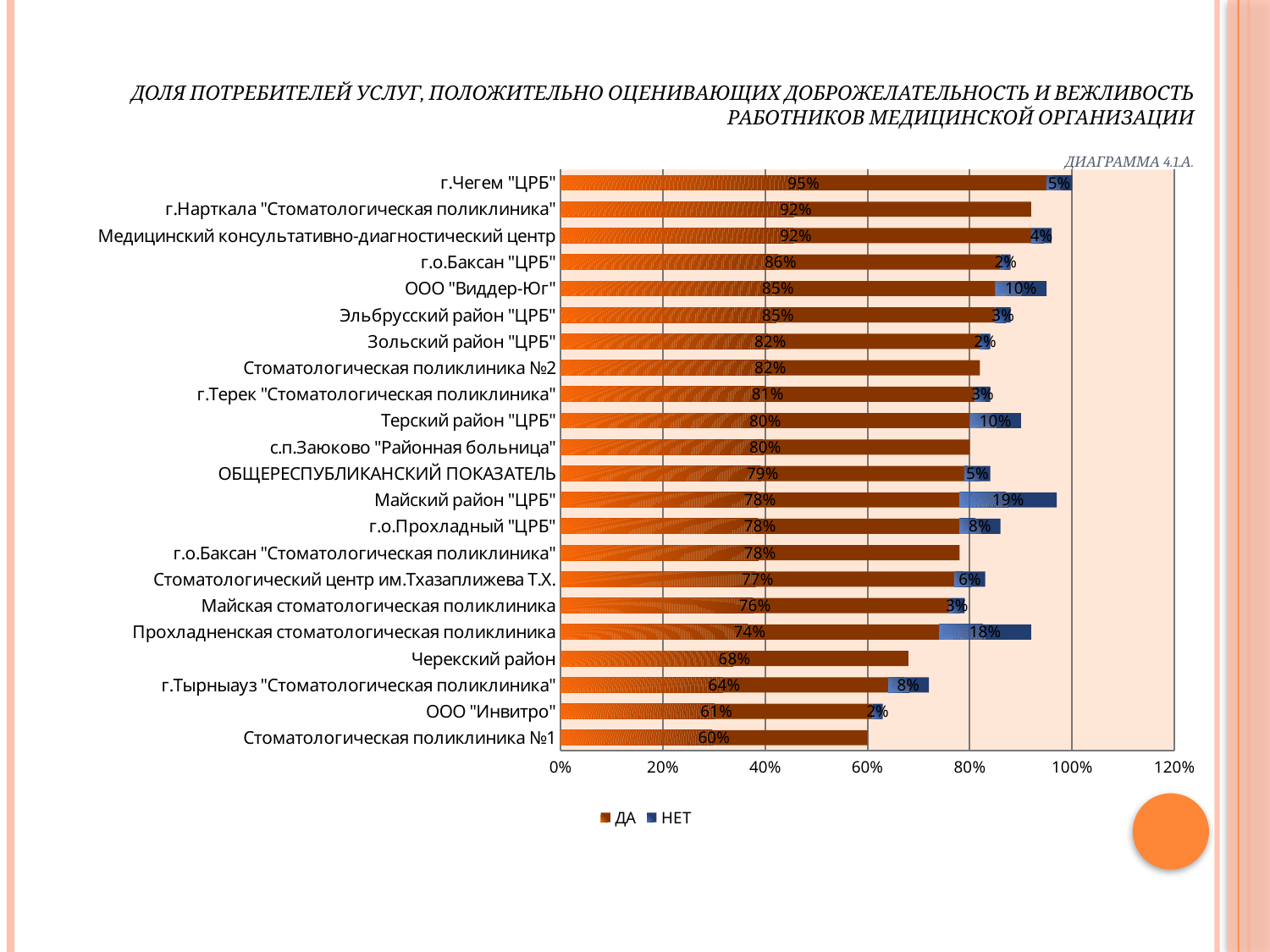
Which category has the highest ДА value? г.Чегем "ЦРБ" What are the two series named in the legend? ДА and НЕТ Which category has the lowest ДА value? Стоматологическая поликлиника №1 What is the ДА value for ОБЩЕРЕСПУБЛИКАНСКИЙ ПОКАЗАТЕЛЬ? 79% How many series does the legend list? 2 What is the total of the stacked bar for Прохладненская стоматологическая поликлиника? 92% What kind of chart is shown on the slide? Stacked bar chart What is the НЕТ value for Майский район "ЦРБ"? 19% What is the ДА value for г.Чегем "ЦРБ"? 95% How many categories are shown on the chart? 22 Which has a larger ДА value, Терский район "ЦРБ" or Черекский район? Терский район "ЦРБ" What is the difference between the ДА values for г.о.Баксан "ЦРБ" and ООО "Инвитро"? 25%